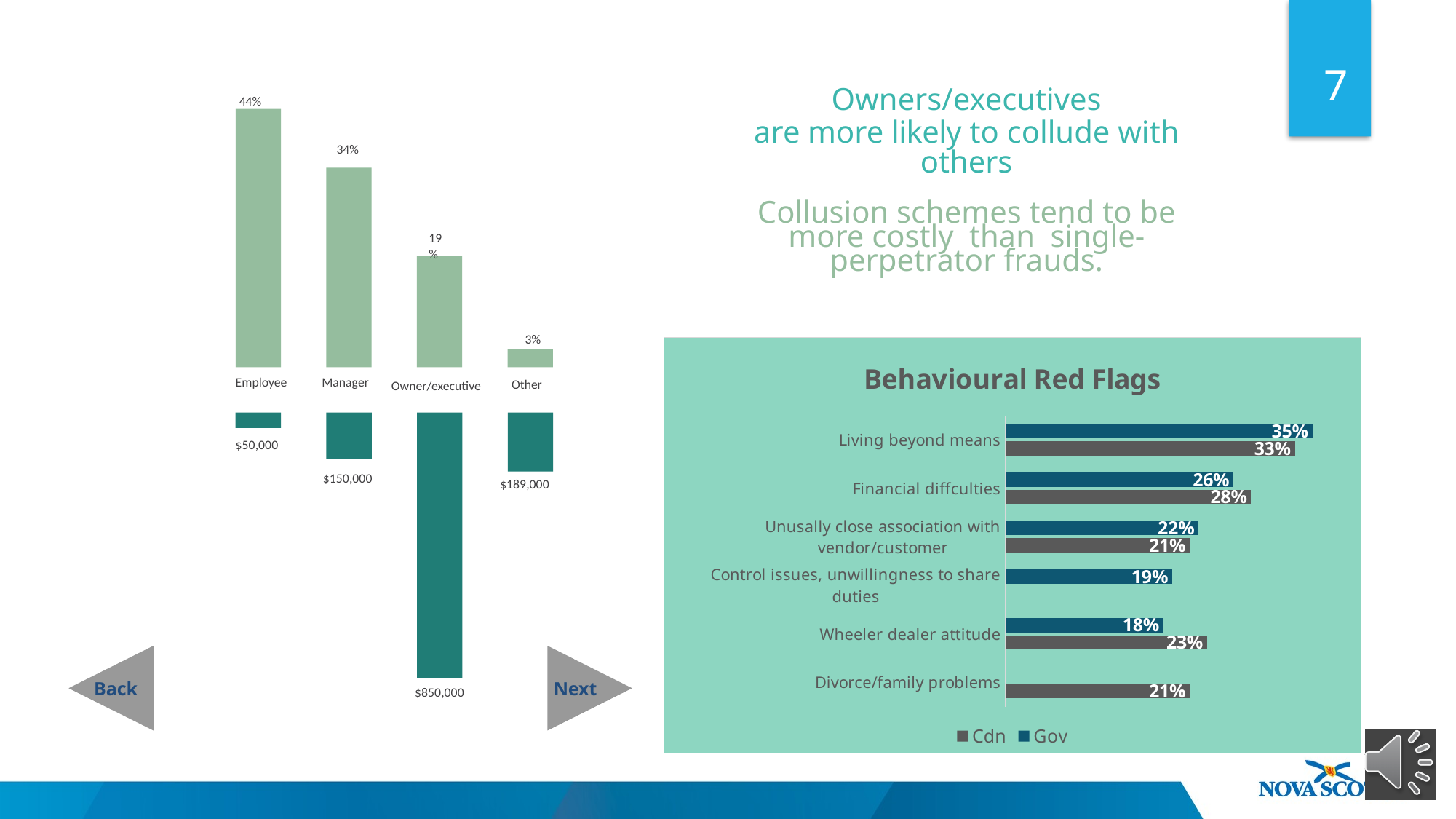
In the Behavioural Red Flags chart, what is the difference between the Cdn and Gov values for Wheeler dealer attitude? 5% In the Behavioural Red Flags chart, what is the Cdn value for Wheeler dealer attitude? 23% How many series does the legend of the Behavioural Red Flags chart list? 2 In the chart on the left of the slide, which category has the lowest percentage? Other In the Behavioural Red Flags chart, which is larger for Financial difficulties, the Cdn value or the Gov value? Cdn In the chart on the left of the slide, what is the difference between the percentages for Employee and Manager? 10% What kind of chart is the Behavioural Red Flags chart? Bar chart In the chart on the left of the slide, what percentage is shown for Employee? 44% In the chart on the left of the slide, what dollar amount is shown for Owner/executive? $850,000 In the chart on the left of the slide, how many categories are shown? 4 In the Behavioural Red Flags chart, what is the Gov value for Living beyond means? 35% In the chart on the left of the slide, which category has the highest dollar amount? Owner/executive